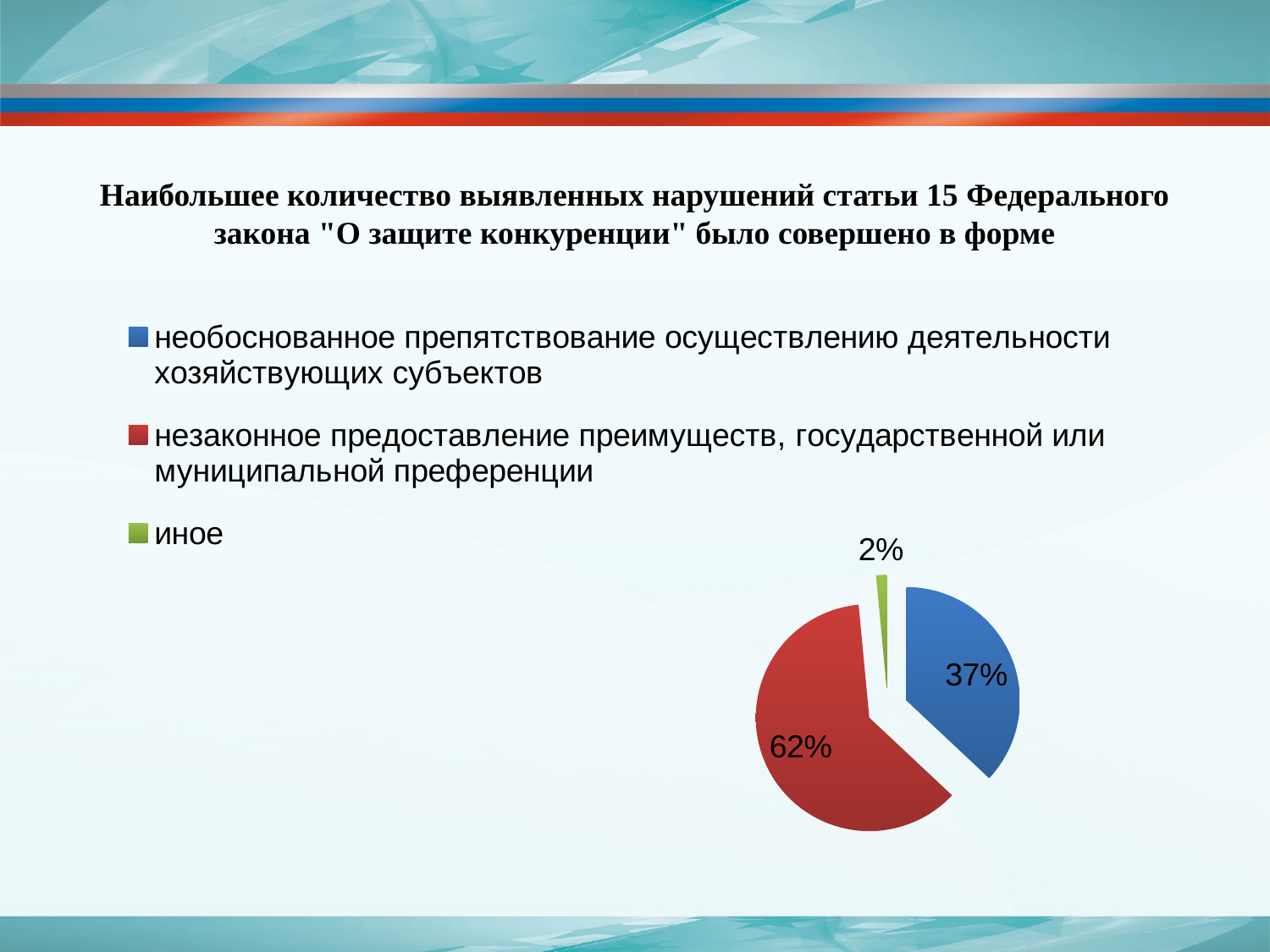
What kind of chart is shown on the slide? pie chart Which category has the smallest slice of the pie? иное What colour is the slice labelled 62%? red Which is larger: the slice for "необоснованное препятствование осуществлению деятельности хозяйствующих субъектов" or the slice for "иное"? необоснованное препятствование осуществлению деятельности хозяйствующих субъектов How many entries does the legend list? 3 How many slices does the pie chart have? 3 What is the difference in percentage points between the slice for "незаконное предоставление преимуществ, государственной или муниципальной преференции" and the slice for "необоснованное препятствование осуществлению деятельности хозяйствующих субъектов"? 25 percentage points What share of the pie does "иное" have? 2% What colour is the slice for "иное"? green What share of the pie does "незаконное предоставление преимуществ, государственной или муниципальной преференции" have? 62% Which category has the largest slice of the pie? незаконное предоставление преимуществ, государственной или муниципальной преференции What share of the pie does "необоснованное препятствование осуществлению деятельности хозяйствующих субъектов" have? 37%